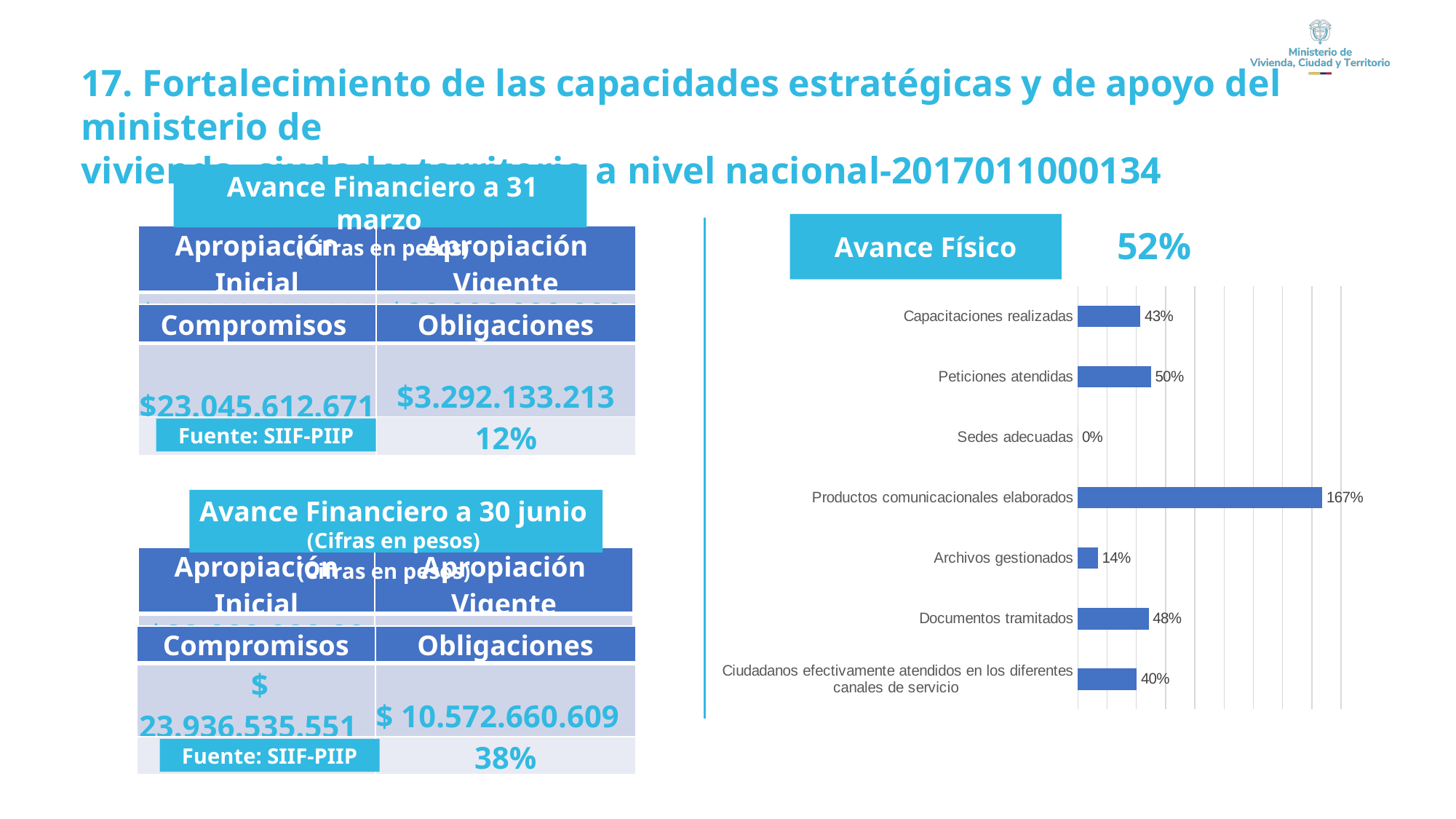
In the Avance Físico chart, which is larger: Capacitaciones realizadas or Archivos gestionados? Capacitaciones realizadas What is the value for Capacitaciones realizadas in the Avance Físico chart? 43% How many categories are shown in the Avance Físico chart? 7 Which category has the highest value in the Avance Físico chart? Productos comunicacionales elaborados What is the value for Peticiones atendidas in the Avance Físico chart? 50% What is the value for Sedes adecuadas in the Avance Físico chart? 0% In the Avance Físico chart, what is the difference between Peticiones atendidas and Documentos tramitados? 2% What type of chart is the Avance Físico chart? Bar chart Which category has the lowest value in the Avance Físico chart? Sedes adecuadas What is the value for Archivos gestionados in the Avance Físico chart? 14% What overall percentage is shown next to the Avance Físico title? 52% What is the value for Productos comunicacionales elaborados in the Avance Físico chart? 167%